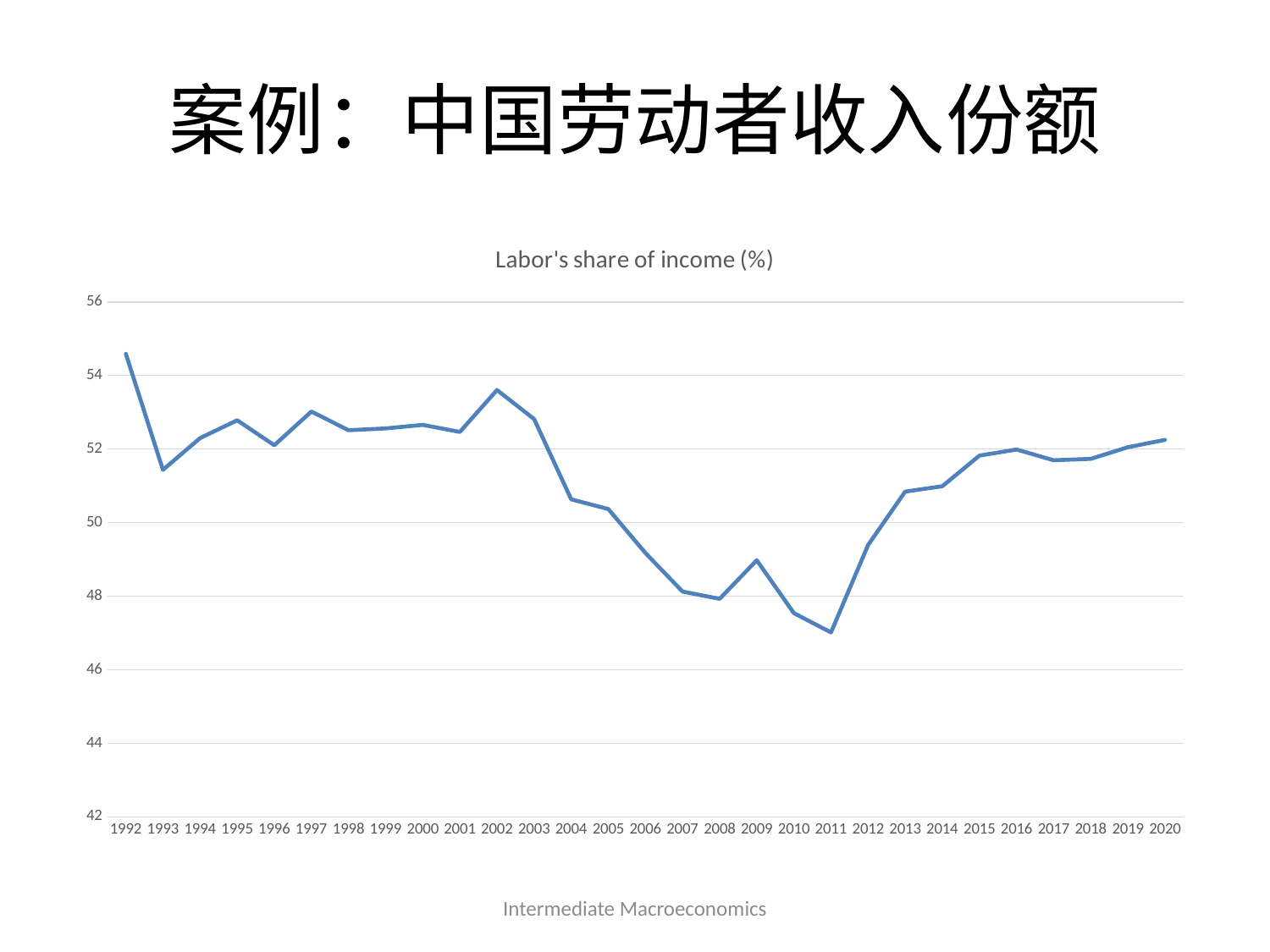
Is the value for 1992 greater or less than 54? greater Which year has a higher labor's share of income, 1992 or 2020? 1992 Which year has a higher labor's share of income, 2005 or 2006? 2005 Which year has the highest labor's share of income? 1992 What kind of chart is shown on the slide? line chart Which year has the lowest labor's share of income? 2011 Is the value for 2011 greater or less than 48? less Is the value for 2004 greater or less than 50? greater How many years are plotted on the x axis of the chart? 29 What is the title of the chart? Labor's share of income (%) Does labor's share of income rise or fall from 2011 to 2020? rise